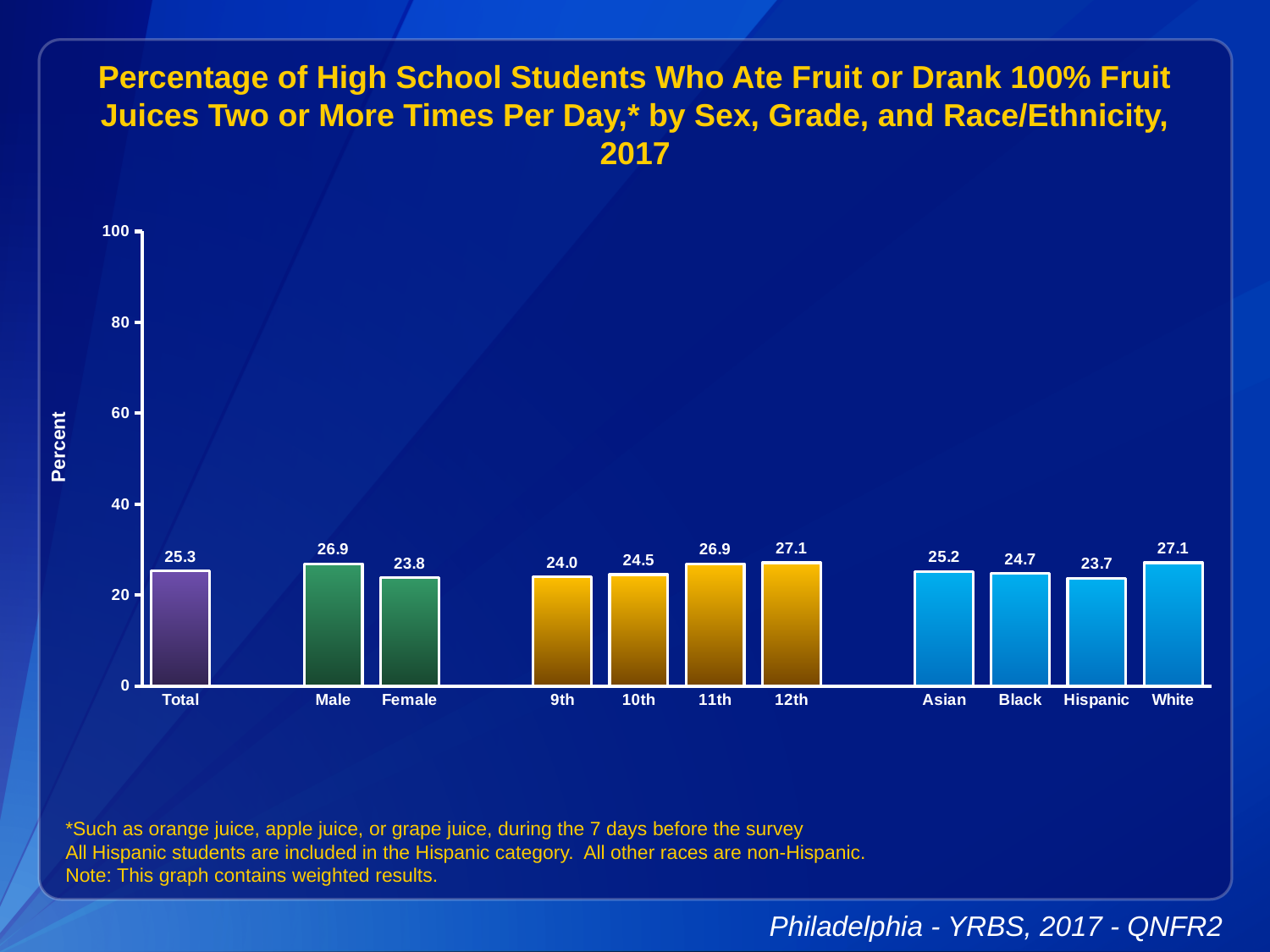
Which grade has the highest value? 12th Do the values rise or fall from 9th grade to 12th grade? rise What is the value for 10th grade? 24.5 Which race/ethnicity category has the lowest value? Hispanic Which is larger, the value for Asian or the value for Black? Asian What is the value for Total? 25.3 What kind of chart is shown on the slide? bar chart Is the value for 9th grade greater or less than 40? less What is the value for Female? 23.8 What is the value for Hispanic students? 23.7 How many bars are shown in the chart? 11 What is the difference between the Male and Female values? 3.1